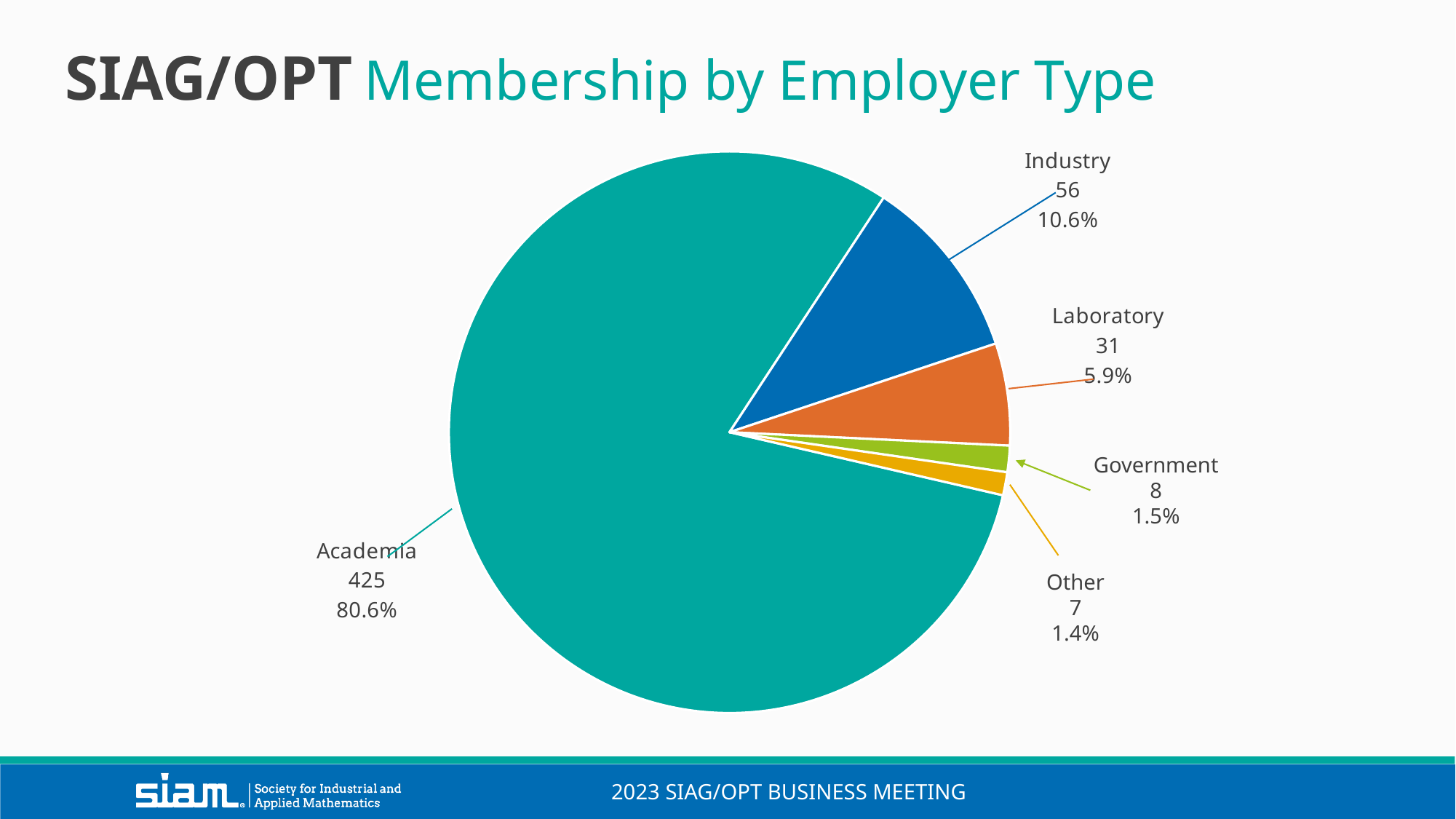
How many members are in the Laboratory category? 31 What is the difference in member count between Industry and Laboratory? 25 How many members are in the Academia category? 425 What percentage share does Industry have? 10.6% What type of chart is shown on the slide? pie chart Which has more members, Laboratory or Government? Laboratory What percentage share does Government have? 1.5% What colour is the Academia slice? teal How many employer type categories are shown in the pie chart? 5 Which employer type has the largest slice? Academia Which employer type has the smallest slice? Other What is the total number of members across all five categories? 527